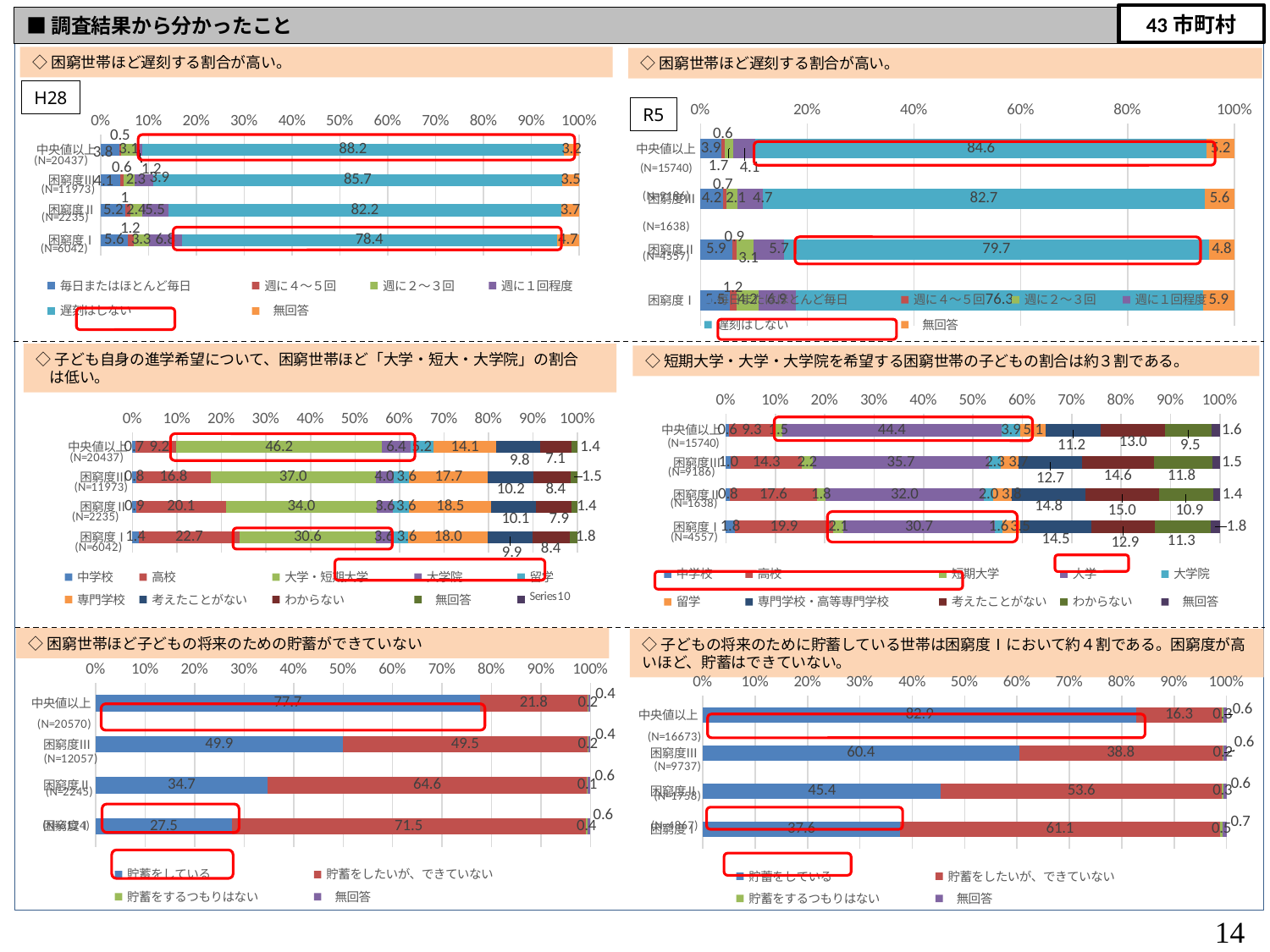
In the middle-right chart (R5 進学希望), what is the value of 大学 for 困窮度Ⅰ? 30.7 In the bottom-right chart (R5 貯蓄), what is the value of 貯蓄をしたいが、できていない for 困窮度Ⅱ? 53.6 In the top-left chart (H28 遅刻), which category has the highest value for 遅刻はしない? 中央値以上 In the bottom-left chart (H28 貯蓄), what is the difference between 貯蓄をしている for 中央値以上 and for 困窮度Ⅰ? 50.2 How many series does the legend of the bottom-right chart (R5 貯蓄) list? 4 In the top-right chart (R5 遅刻), which category has the lowest value for 遅刻はしない? 困窮度Ⅰ How many categories (bars) are shown in the bottom-left chart (H28 貯蓄)? 4 In the bottom-right chart (R5 貯蓄), is the value of 貯蓄をしている for 困窮度Ⅲ greater or less than 50%? greater In the bottom-right chart (R5 貯蓄), what is the value of 貯蓄をしている for 困窮度Ⅰ? 37.6 In the middle-left chart (H28 進学希望), which is larger: 大学・短期大学 for 中央値以上 or for 困窮度Ⅰ? 中央値以上 In the bottom-left chart (H28 貯蓄), what is the value of 貯蓄をしている for 中央値以上? 77.7 What type of chart is the top-left chart (H28 遅刻)? Stacked bar chart